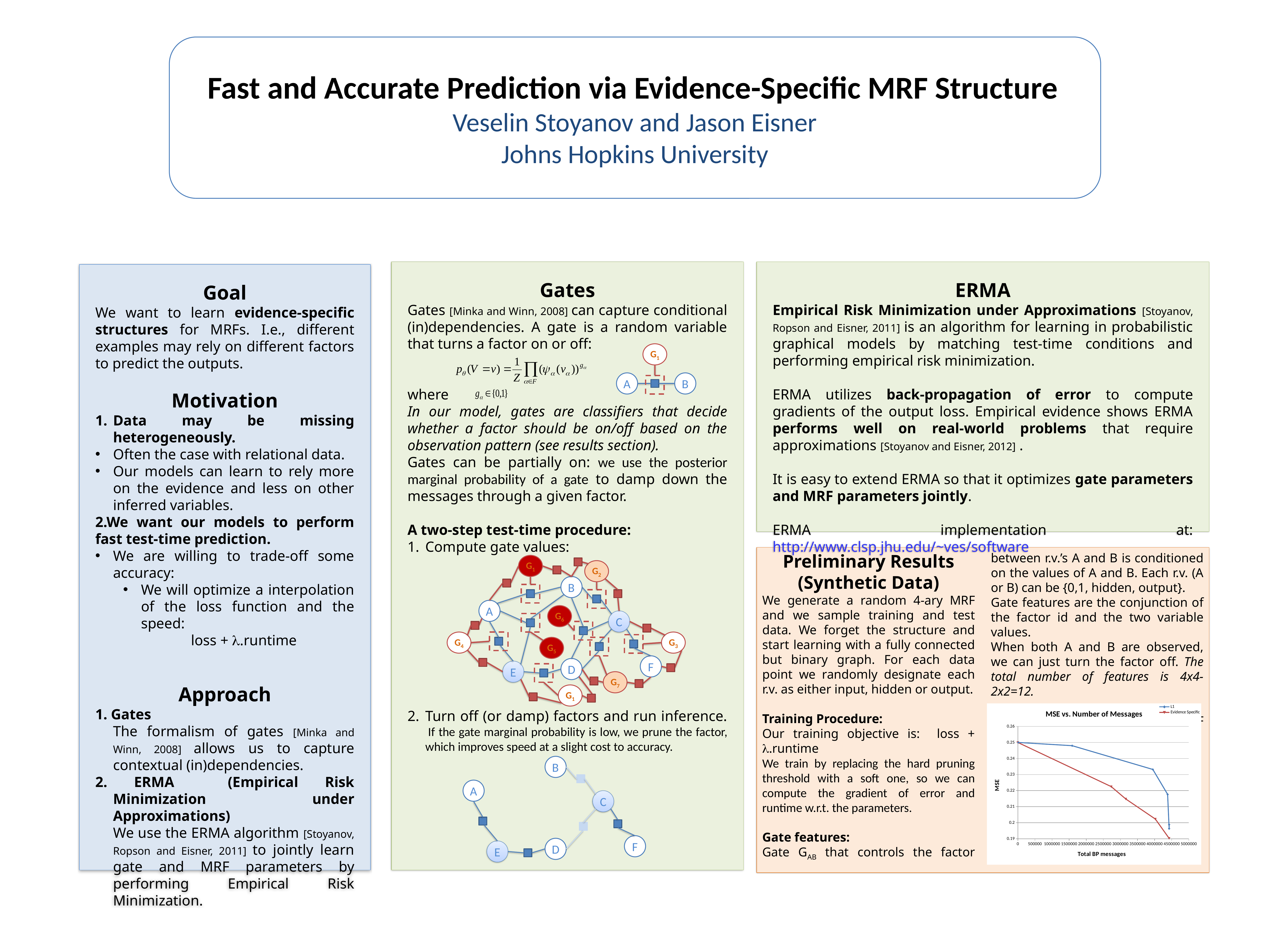
In the "MSE vs. Number of Messages" chart, is the MSE of the Evidence Specific series at 3000000 messages greater or less than 0.23? less In the "MSE vs. Number of Messages" chart, is the MSE of the L1 series at 1500000 messages greater or less than 0.24? greater What is the x-axis label of the "MSE vs. Number of Messages" chart? Total BP messages In the "MSE vs. Number of Messages" chart, is the MSE of the Evidence Specific series at 4000000 messages greater or less than 0.21? less What is the title of the chart in the Preliminary Results section? MSE vs. Number of Messages How many series does the legend of the "MSE vs. Number of Messages" chart list? 2 In the "MSE vs. Number of Messages" chart, does MSE rise or fall as the number of BP messages increases? fall What kind of chart is the "MSE vs. Number of Messages" chart? line chart In the "MSE vs. Number of Messages" chart, which series reaches the lower MSE at its final point? Evidence Specific In the "MSE vs. Number of Messages" chart, which series has the higher MSE at 3000000 messages, L1 or Evidence Specific? L1